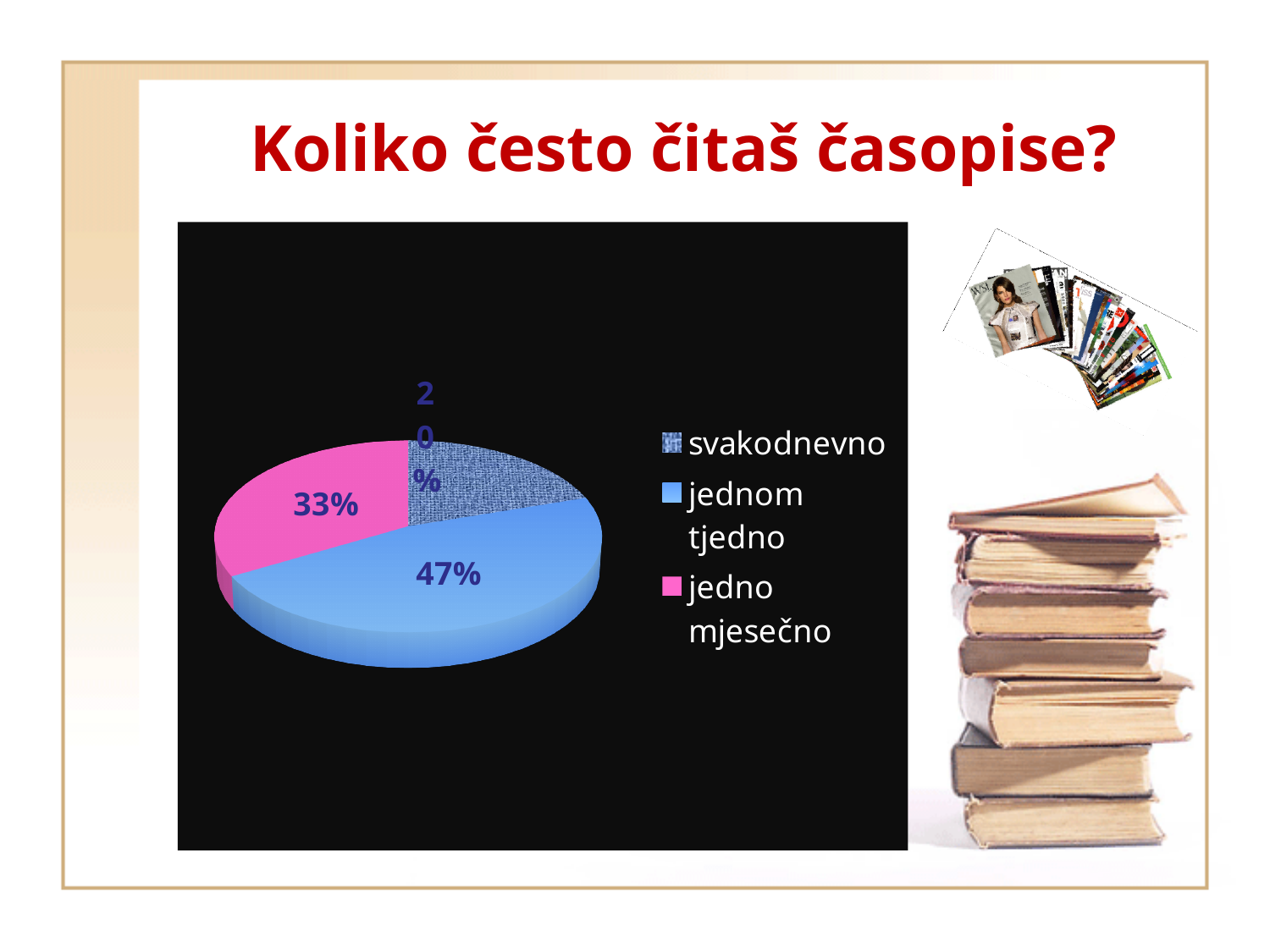
What share of the pie is labelled for 'svakodnevno'? 20% What share of the pie is labelled for 'jednom tjedno'? 47% What colour is the slice for 'jedno mjesečno'? pink What is the difference in percentage points between 'jedno mjesečno' and 'svakodnevno'? 13 Which category has the smallest slice of the pie? svakodnevno What kind of chart is shown on the slide? pie chart Which category has the largest slice of the pie? jednom tjedno What is the difference in percentage points between 'jednom tjedno' and 'jedno mjesečno'? 14 How many slices does the pie chart have? 3 How many entries does the legend list? 3 What share of the pie is labelled for 'jedno mjesečno'? 33% Which is larger, the slice for 'jedno mjesečno' or the slice for 'svakodnevno'? jedno mjesečno